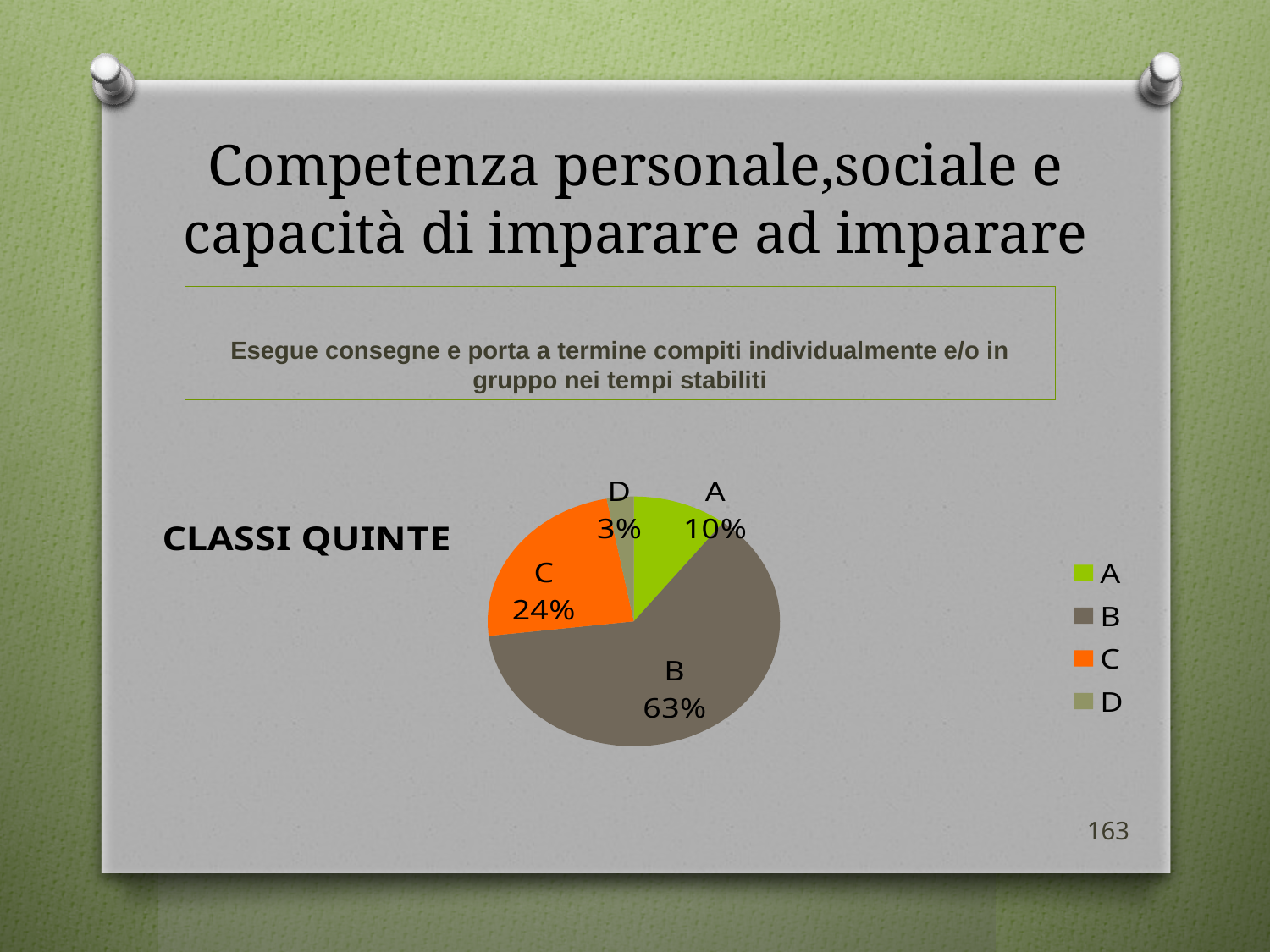
What percentage does slice A represent in the pie chart? 10% How many slices does the pie chart have? 4 What percentage does slice D represent in the pie chart? 3% Which slice of the pie chart is the smallest? D How many entries does the legend list? 4 What percentage does slice B represent in the pie chart? 63% What colour is slice C in the pie chart? orange What percentage does slice C represent in the pie chart? 24% What kind of chart is shown on the slide? pie chart What is the difference in percentage points between slice B and slice C? 39 Which is larger, slice A or slice C? C Which slice of the pie chart is the largest? B